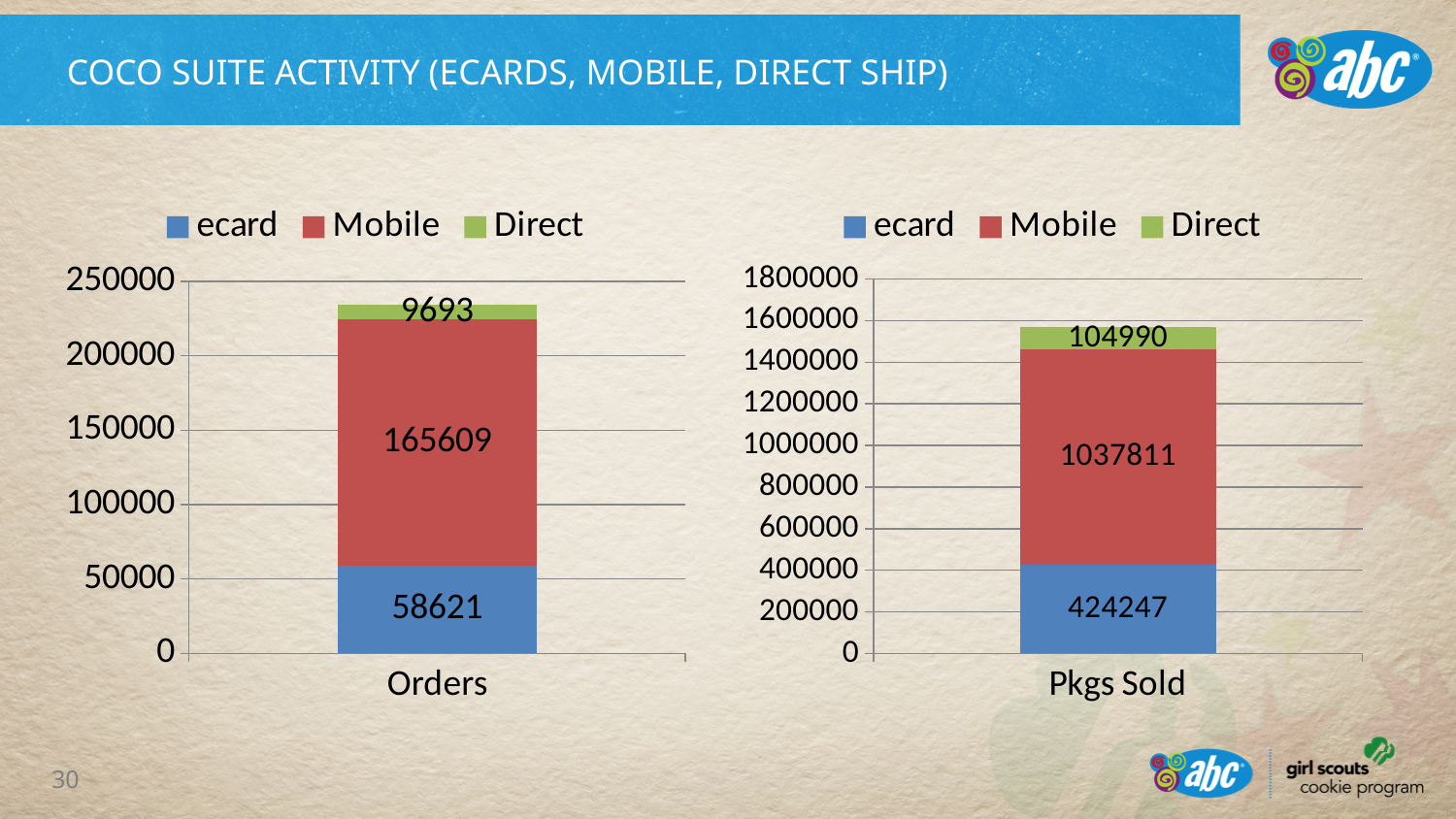
In the left chart (Orders), what is the difference between the Mobile and ecard values? 106988 In the right chart (Pkgs Sold), what is the total of the stacked bar? 1567048 In the left chart (Orders), what is the total of the stacked bar? 233923 In the right chart (Pkgs Sold), what is the value for ecard? 424247 What kind of chart is the left chart (Orders)? Stacked bar chart In the left chart (Orders), what colour represents the Mobile series? Red How many series does the legend of the right chart (Pkgs Sold) list? 3 In the right chart (Pkgs Sold), which series has the highest value? Mobile In the left chart (Orders), what is the value for Mobile? 165609 In the left chart (Orders), what is the value for Direct? 9693 In the right chart (Pkgs Sold), which is larger, the ecard value or the Direct value? ecard In the left chart (Orders), which series has the lowest value? Direct